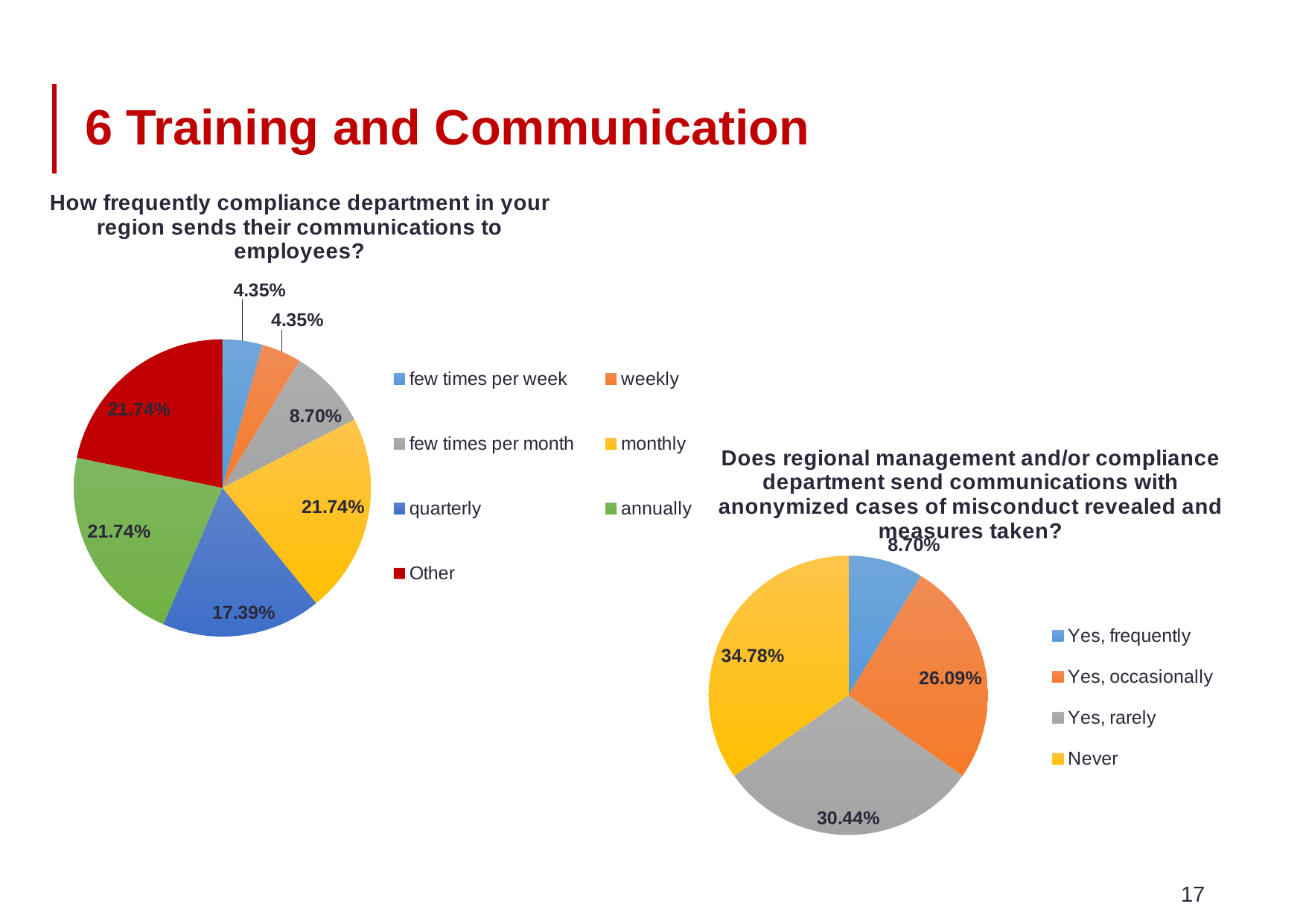
On the right chart (communications with anonymized cases of misconduct), what is the difference between 'Never' and 'Yes, rarely'? 4.34% On the left chart (how frequently compliance department sends communications), which is larger, 'monthly' or 'quarterly'? monthly What kind of chart is the right chart (communications with anonymized cases of misconduct)? pie chart On the right chart (communications with anonymized cases of misconduct), what colour is the 'Never' slice? yellow On the left chart (how frequently compliance department sends communications), what share is labelled for 'weekly'? 4.35% On the left chart (how frequently compliance department sends communications), what share is labelled for 'few times per month'? 8.70% On the left chart (how frequently compliance department sends communications), how many categories does the legend list? 7 On the right chart (communications with anonymized cases of misconduct), which category has the smallest share? Yes, frequently On the left chart (how frequently compliance department sends communications), what is the difference between 'monthly' and 'few times per month'? 13.04% On the right chart (communications with anonymized cases of misconduct), which category has the largest share? Never On the right chart (communications with anonymized cases of misconduct), what share is labelled for 'Yes, occasionally'? 26.09% On the left chart (how frequently compliance department sends communications), what share is labelled for 'quarterly'? 17.39%